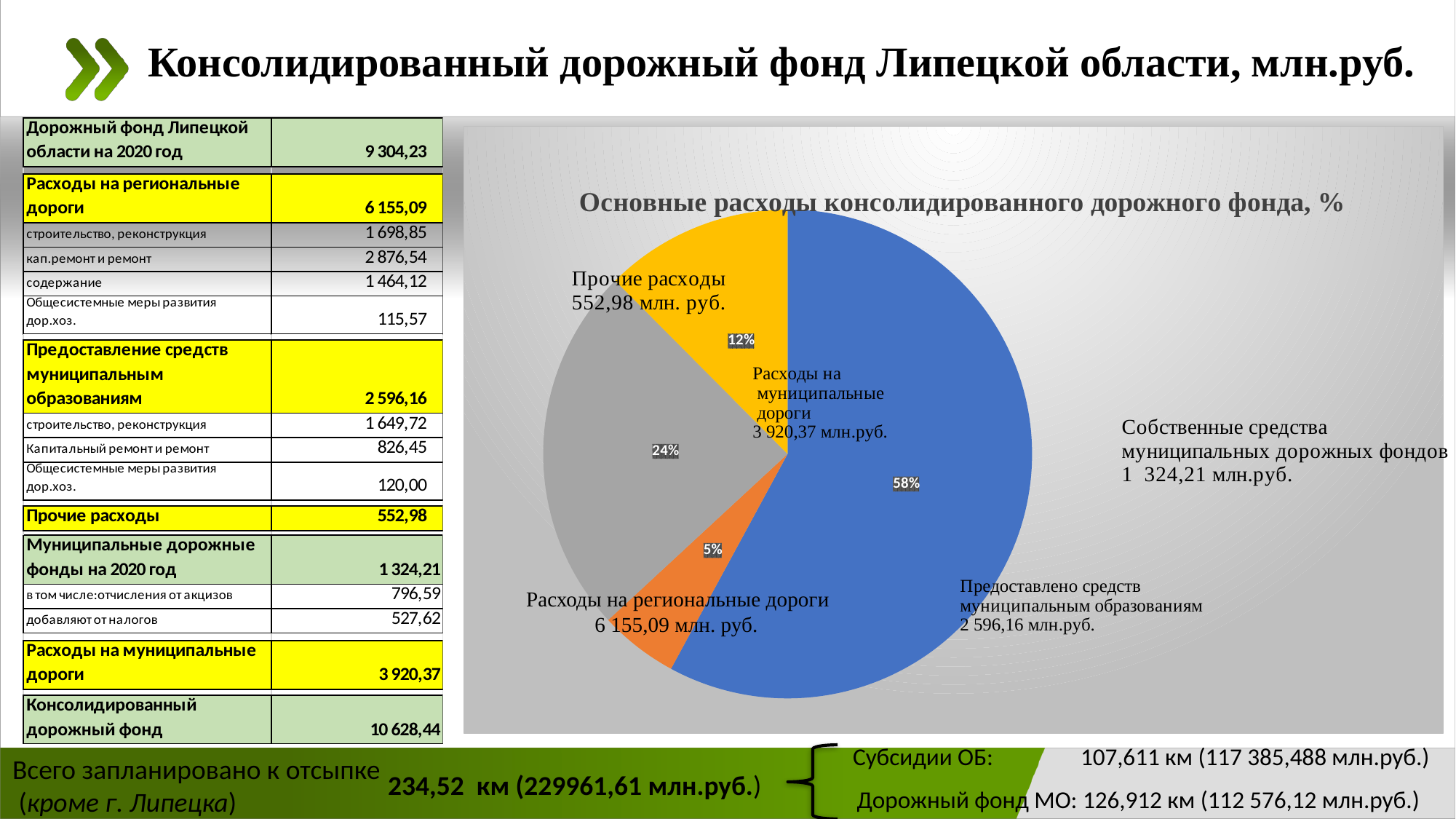
According to the chart label, what amount is given for 'Предоставлено средств муниципальным образованиям'? 2 596,16 млн.руб. What is the smallest percentage shown on the pie chart? 5% What is the title of the pie chart? Основные расходы консолидированного дорожного фонда, % According to the chart label, what amount is given for 'Собственные средства муниципальных дорожных фондов'? 1 324,21 млн.руб. How many slices does the pie chart have? 4 What colour is the slice labelled 58% in the pie chart? blue According to the chart label, what amount is given for 'Прочие расходы'? 552,98 млн. руб. According to the chart label, what amount is given for 'Расходы на региональные дороги'? 6 155,09 млн. руб. What is the largest percentage shown on the pie chart? 58% Which is larger in the pie chart: the grey slice (24%) or the yellow slice (12%)? the grey slice (24%) What is the difference in percentage points between the 58% slice and the 24% slice? 34 What kind of chart is shown on the slide? pie chart